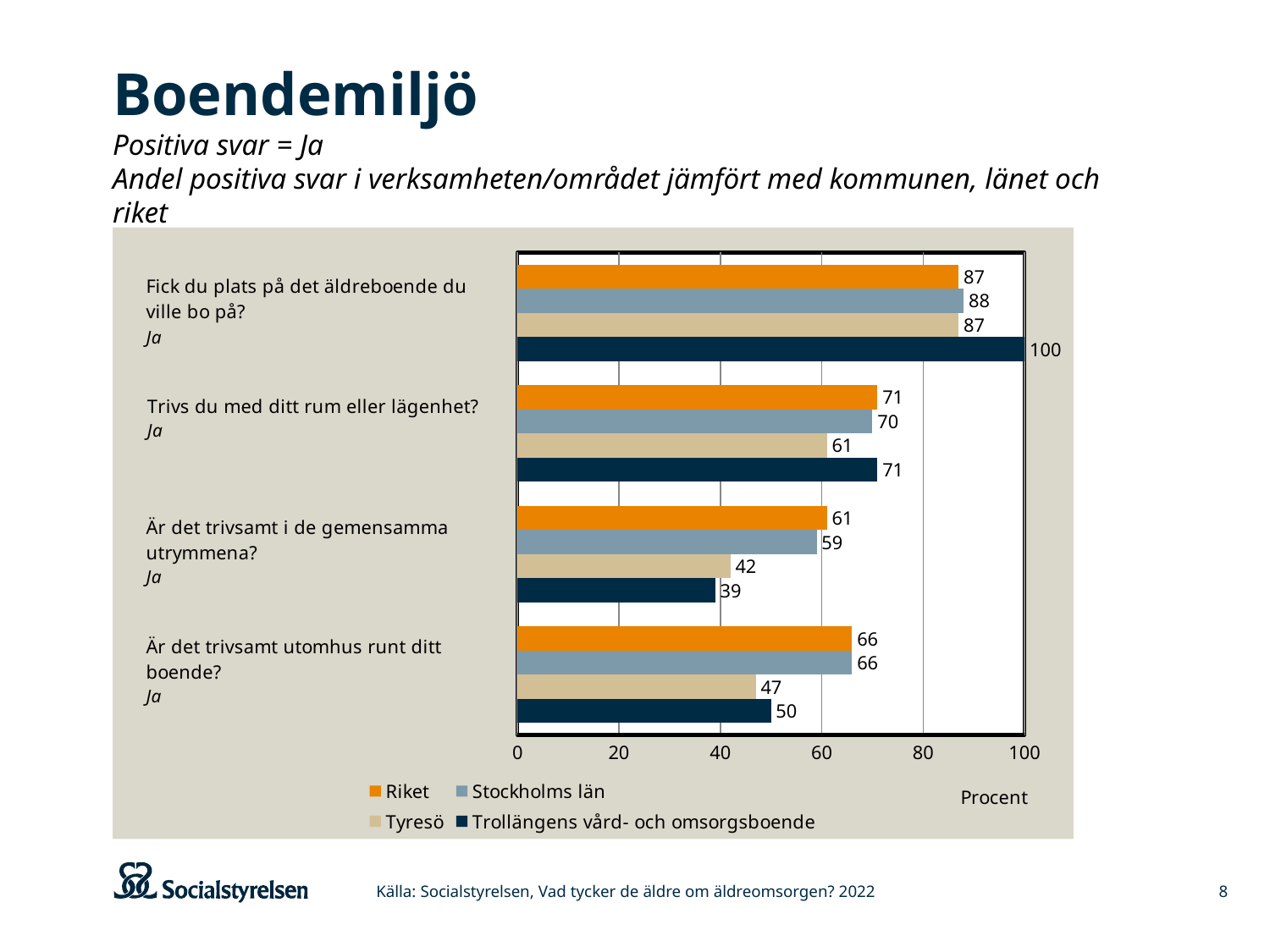
What is the value for Trollängens vård- och omsorgsboende for "Fick du plats på det äldreboende du ville bo på?"? 100 How many question categories are shown in the chart? 4 What is the value for Riket for "Är det trivsamt utomhus runt ditt boende?"? 66 Which series has the highest value for "Fick du plats på det äldreboende du ville bo på?"? Trollängens vård- och omsorgsboende What is the difference between Riket and Tyresö for "Är det trivsamt utomhus runt ditt boende?"? 19 How many series does the legend list? 4 What unit is shown on the x axis of the chart? Procent What kind of chart is shown on the slide? Bar chart What is the value for Stockholms län for "Trivs du med ditt rum eller lägenhet?"? 70 Which is larger for "Trivs du med ditt rum eller lägenhet?": Tyresö or Trollängens vård- och omsorgsboende? Trollängens vård- och omsorgsboende Which series has the lowest value for "Är det trivsamt i de gemensamma utrymmena?"? Trollängens vård- och omsorgsboende What is the value for Tyresö for "Är det trivsamt i de gemensamma utrymmena?"? 42